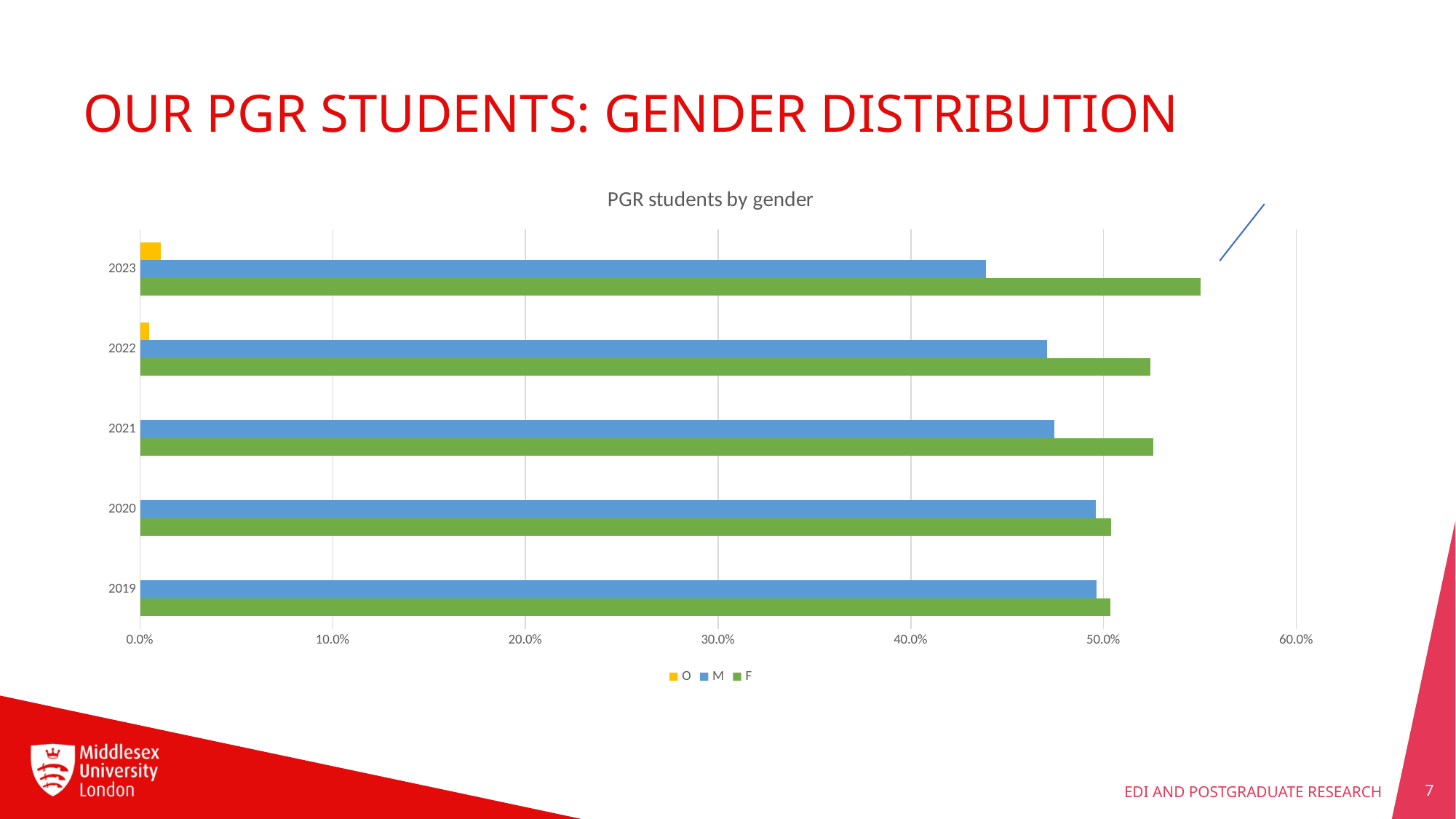
Does the value for M rise or fall from 2019 to 2023? Fall What kind of chart is shown on the slide? Bar chart Is the value for F in 2023 greater or less than 50.0%? greater How many years are shown on the vertical axis of the chart? 5 Is the value for M in 2022 greater or less than 50.0%? less In 2023, which is larger, the value for F or the value for M? F What is the title of the chart? PGR students by gender How many series does the legend list? 3 Which year has the lowest value for M? 2023 Is the value for M in 2023 greater or less than 50.0%? less Which colour represents the F series in the chart? Green Which year has the highest value for F? 2023